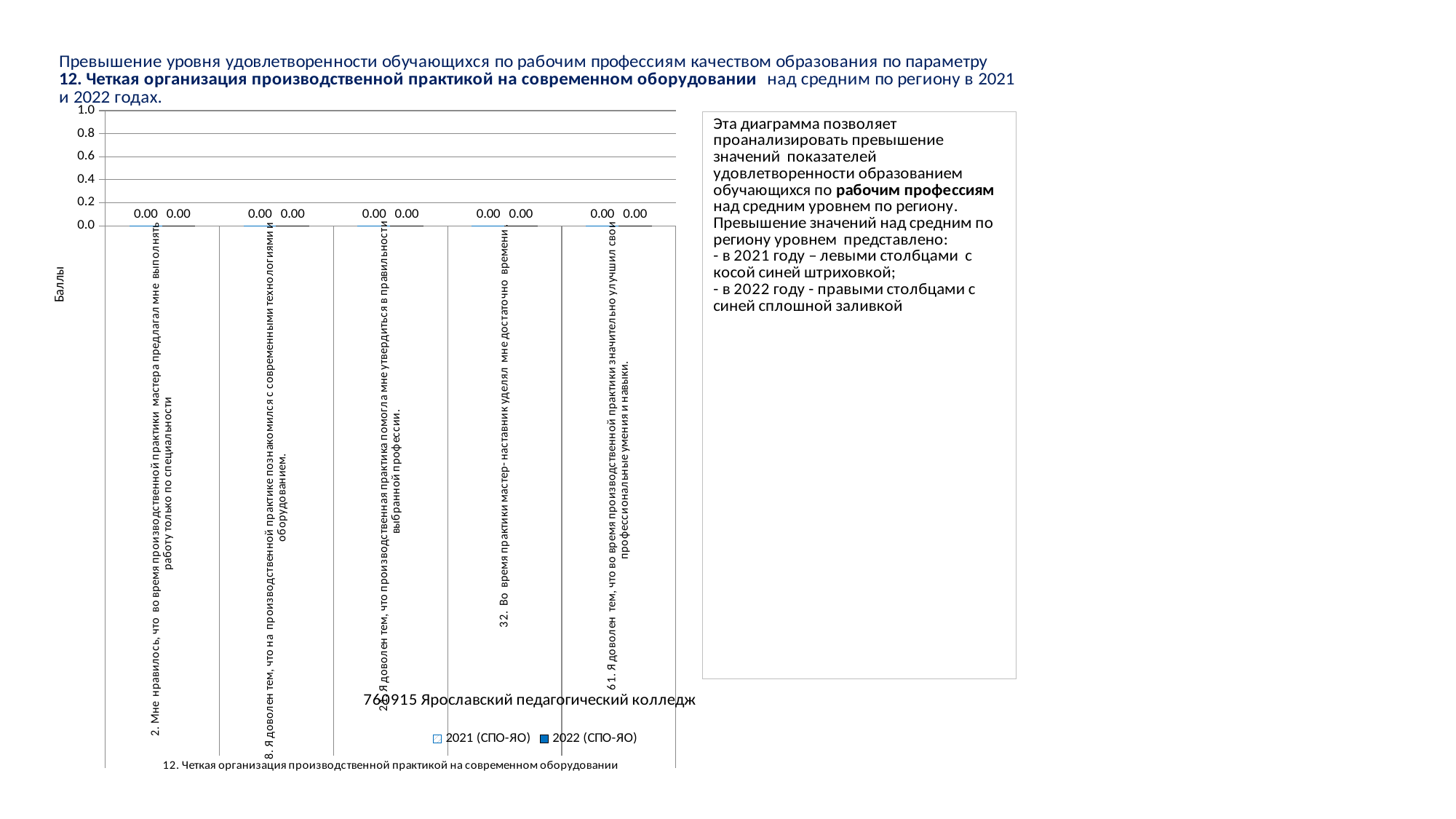
What is the value for the 2022 (СПО-ЯО) series for category 8 ("Я доволен тем, что на производственной практике познакомился с современными технологиями и оборудованием")? 0.00 Is the value for the 2022 (СПО-ЯО) series for category 2 greater or less than 0.2? less How many categories are shown on the x axis of the chart? 5 What are the two series names listed in the chart legend? 2021 (СПО-ЯО) and 2022 (СПО-ЯО) What is the value for the 2021 (СПО-ЯО) series for category 2 ("Мне нравилось, что во время производственной практики мастера предлагал мне выполнять работу только по специальности")? 0.00 What is the label of the vertical axis of the chart? Баллы How many series does the chart legend list? 2 Do the values for the 2021 (СПО-ЯО) series rise, fall, or stay flat across the categories? Stay flat What is the value for the 2022 (СПО-ЯО) series for category 32 ("Во время практики мастер-наставник уделял мне достаточно времени")? 0.00 What is the value for the 2021 (СПО-ЯО) series for category 61 ("Я доволен тем, что во время производственной практики значительно улучшил свои профессиональные умения и навыки")? 0.00 What kind of chart is shown on the slide? Bar chart